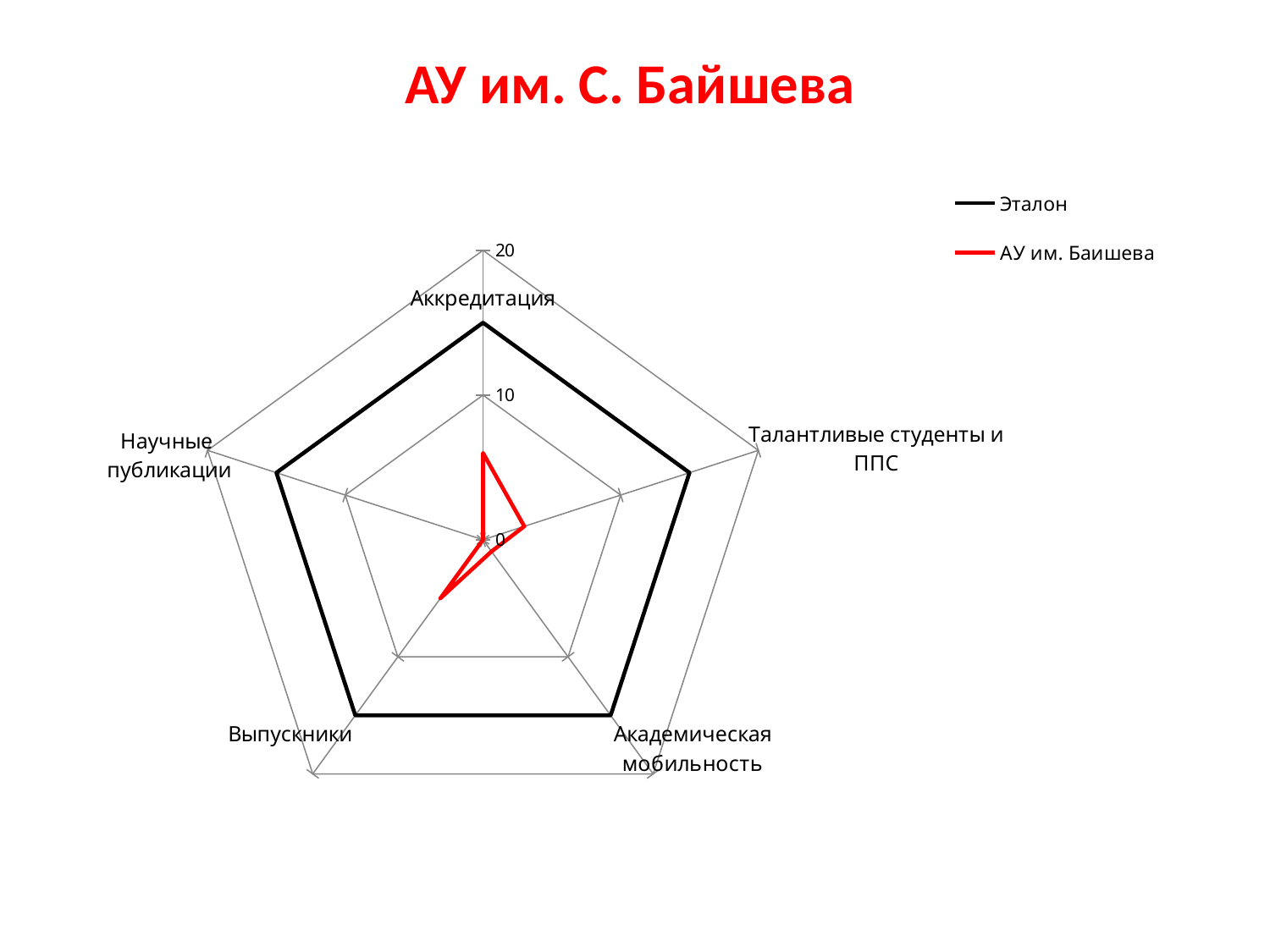
How many series does the legend list? 2 For the АУ им. Баишева series, which category has the highest value? Аккредитация Is the Эталон value for Аккредитация greater or less than 10? greater What colour is the line for the Эталон series? Black Which two series are listed in the legend? Эталон and АУ им. Баишева What kind of chart is shown on the slide? Radar chart Is the АУ им. Баишева value for Талантливые студенты и ППС greater or less than 10? less For Выпускники, which series has the larger value, Эталон or АУ им. Баишева? Эталон Is the АУ им. Баишева value for Аккредитация greater or less than 10? less For the АУ им. Баишева series, which is larger: the value for Аккредитация or the value for Талантливые студенты и ППС? Аккредитация How many categories (axes) does the radar chart have? 5